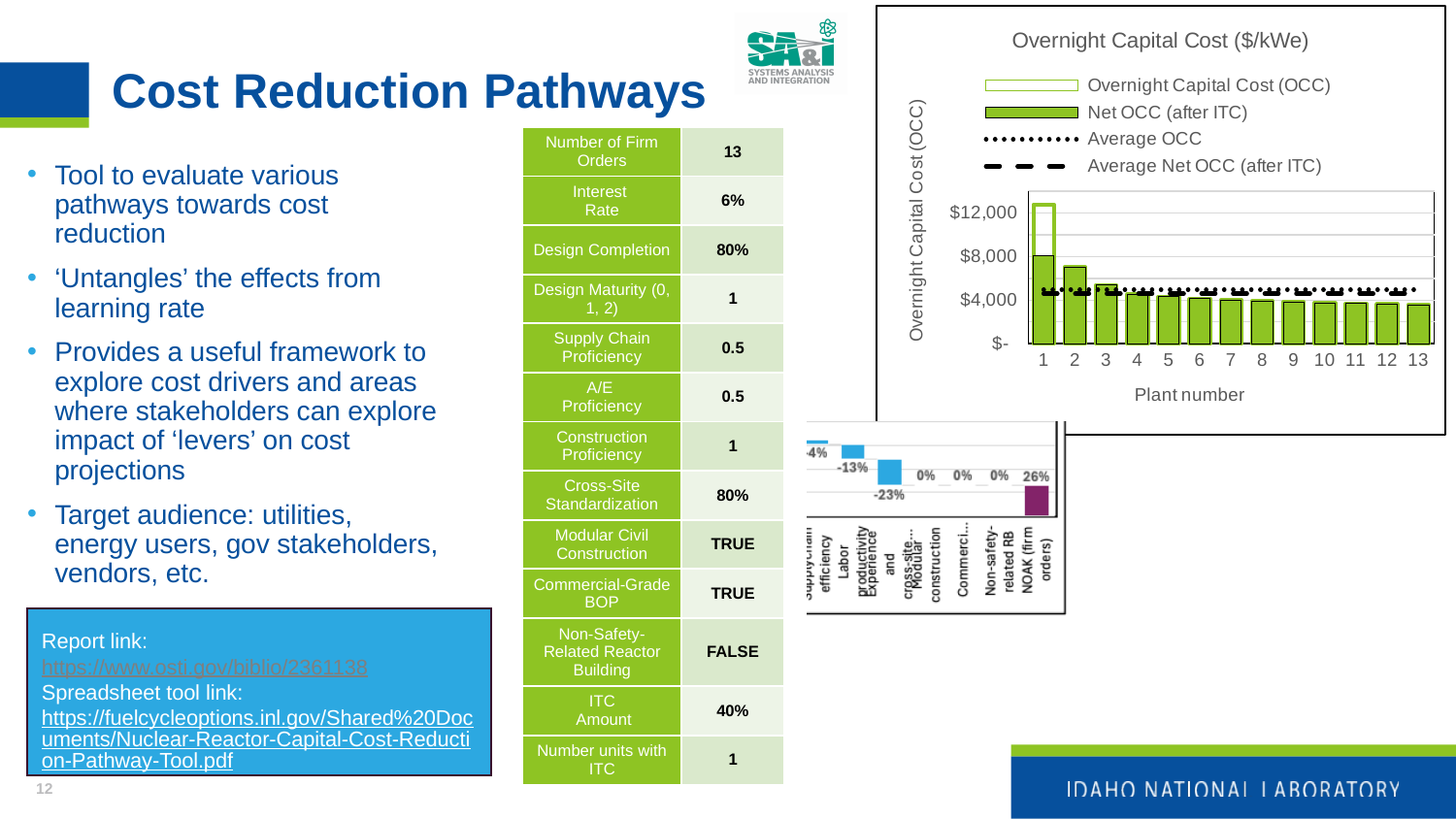
What is the x-axis label of the Overnight Capital Cost chart? Plant number In the Overnight Capital Cost chart, is the Overnight Capital Cost (OCC) for plant 1 greater or less than $8,000? greater In the Overnight Capital Cost chart, how many plant numbers are shown on the x axis? 13 What is the title of the chart in the upper right of the slide? Overnight Capital Cost ($/kWe) In the partially visible chart at the bottom of the slide, what value is shown for NOAK (firm orders)? 26% In the Overnight Capital Cost chart, do the bar values rise or fall as the plant number increases? fall What kind of chart is the Overnight Capital Cost ($/kWe) chart? bar chart In the Overnight Capital Cost chart, is the Net OCC (after ITC) for plant 2 greater or less than $8,000? less In the Overnight Capital Cost chart, how many series does the legend list? 4 In the Overnight Capital Cost chart, which is larger, the Net OCC (after ITC) for plant 1 or for plant 5? plant 1 In the Overnight Capital Cost chart, which plant number has the highest overnight capital cost? 1 In the Overnight Capital Cost chart, is the Net OCC (after ITC) for plant 2 greater or less than $4,000? greater